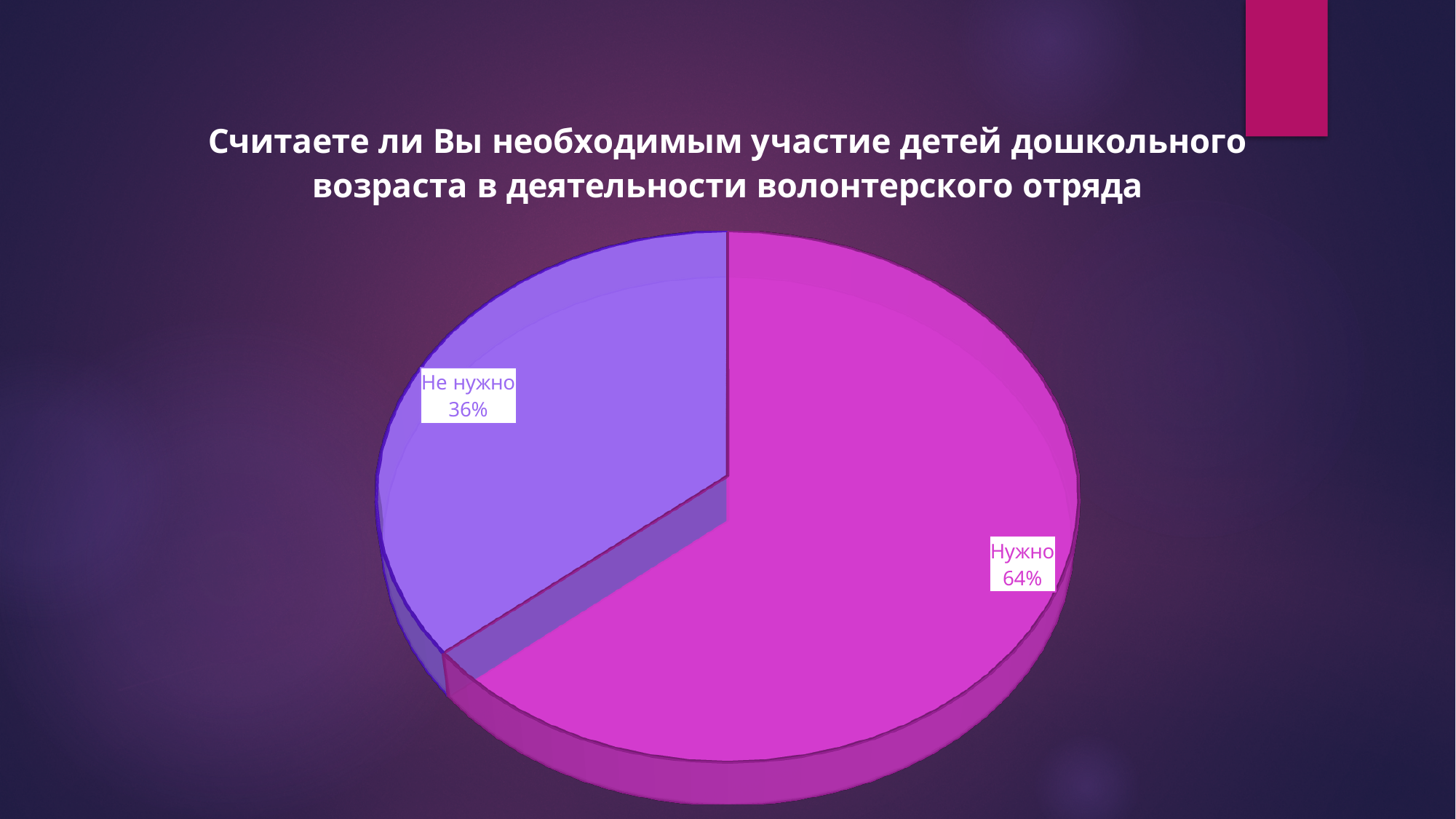
What colour is the "Не нужно" slice? purple Which slice is the smallest? Не нужно What is the difference in percentage points between the "Нужно" and "Не нужно" slices? 28 What is the title of the chart? Считаете ли Вы необходимым участие детей дошкольного возраста в деятельности волонтерского отряда Which slice is the largest? Нужно What share of the pie does the "Не нужно" slice represent? 36% What share of the pie does the "Нужно" slice represent? 64% Which is larger, the "Нужно" slice or the "Не нужно" slice? Нужно What kind of chart is shown on the slide? pie chart How many slices does the pie chart have? 2